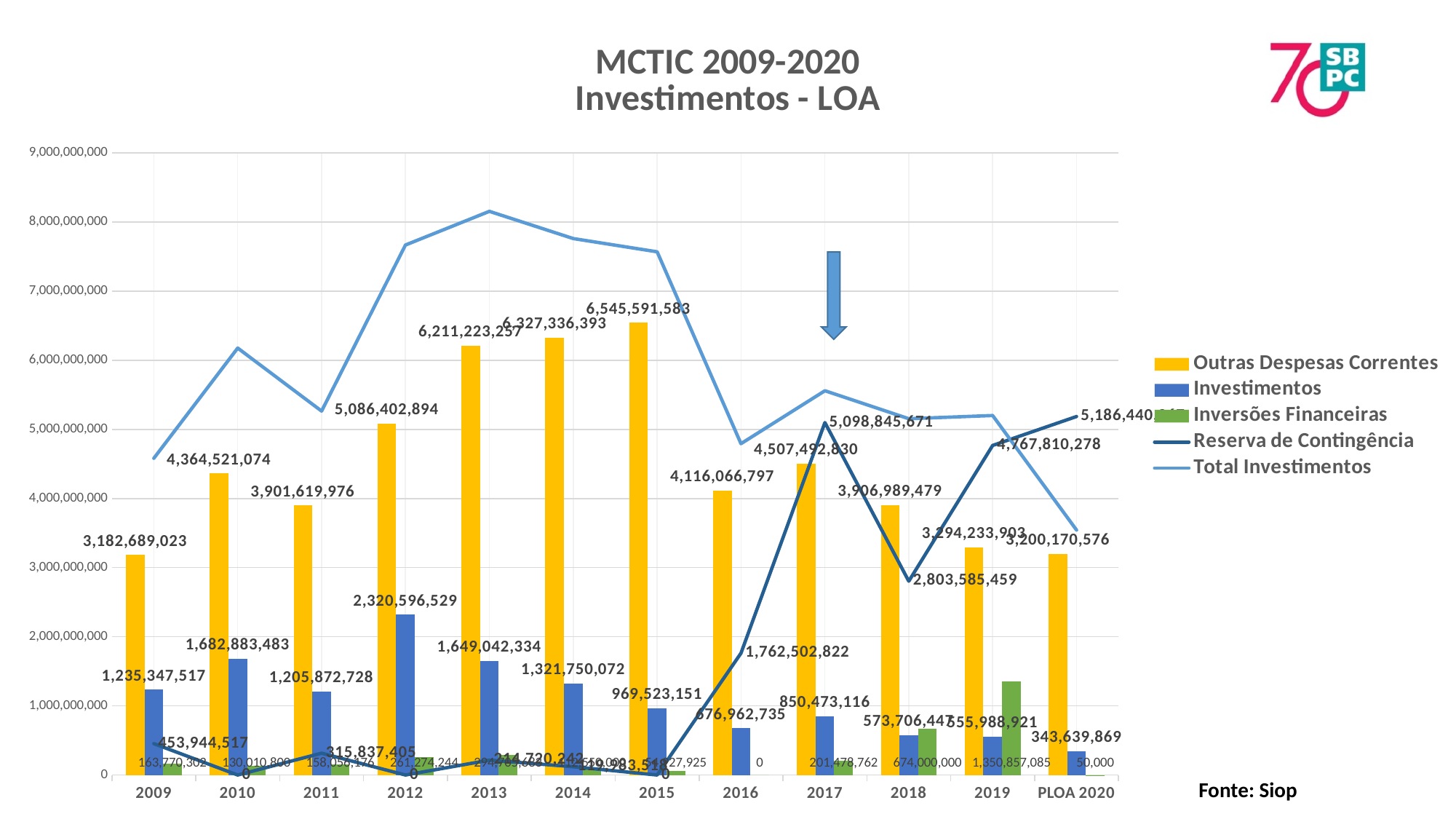
How many series does the legend list? 5 Is the Total Investimentos value for 2013 greater or less than 8,000,000,000? greater What is the value of Investimentos for 2017? 850,473,116 In which year is Outras Despesas Correntes highest? 2015 Which year has the larger Investimentos value, 2010 or 2013? 2010 What kind of chart is shown on the slide? A combined bar and line chart Which category has the lowest Investimentos value? PLOA 2020 What is the difference between Outras Despesas Correntes in 2014 and in 2013? 116,113,136 How many year categories are shown along the x axis? 12 In which year is Investimentos highest? 2012 What is the value of Reserva de Contingência for 2017? 5,098,845,671 What is the value of Outras Despesas Correntes for 2015? 6,545,591,583